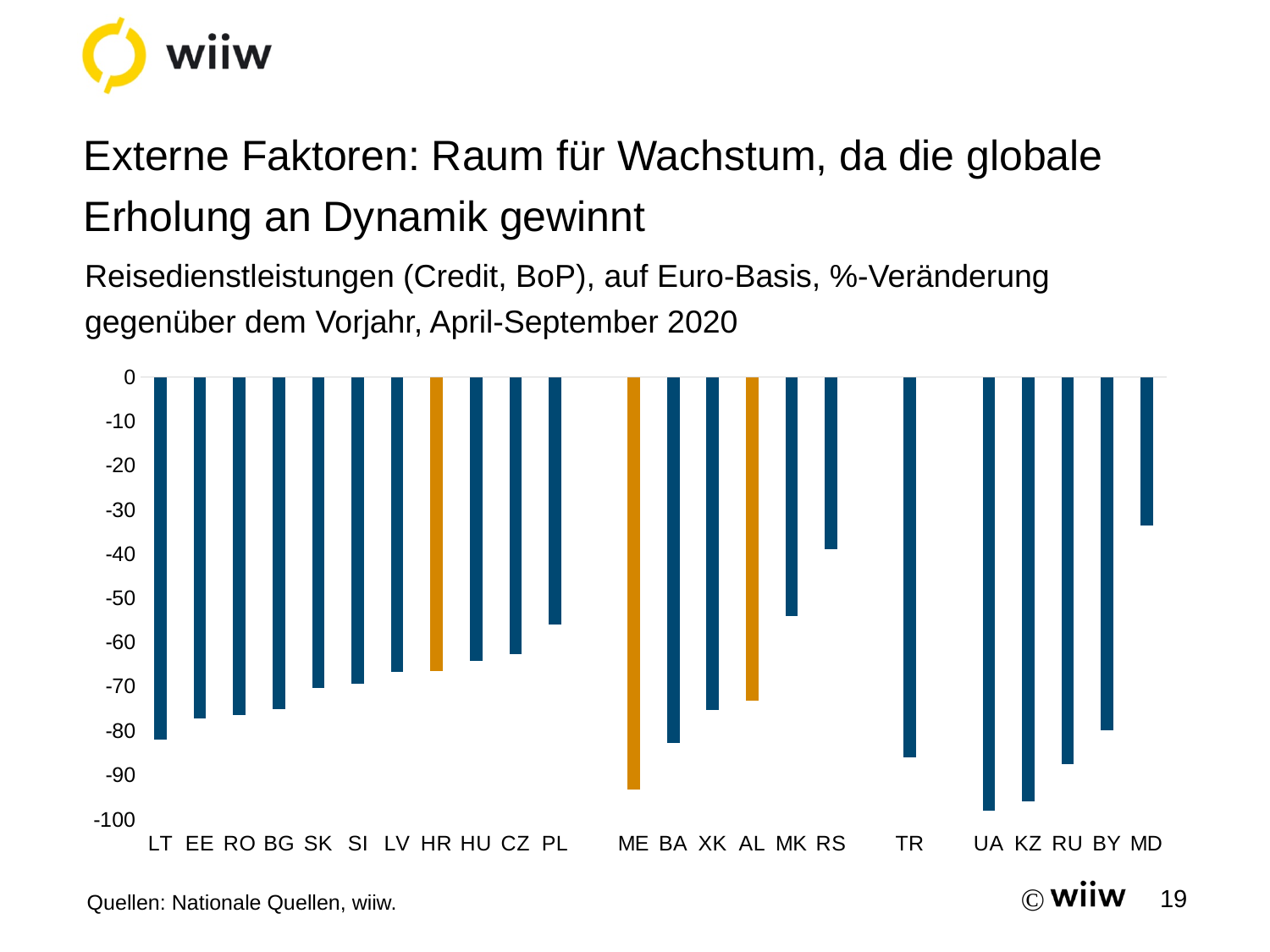
Is the value for LT greater or less than -70? less Is the value for TR greater or less than -80? less Is the value for RS greater or less than -50? greater Which has the larger value, PL or LT? PL Which has the larger value, MD or ME? MD What kind of chart is shown on the slide? bar chart Which country has the highest (least negative) value in the chart? MD Which bars are coloured orange rather than dark blue? HR, ME, AL How many countries (bars) are plotted in the chart? 23